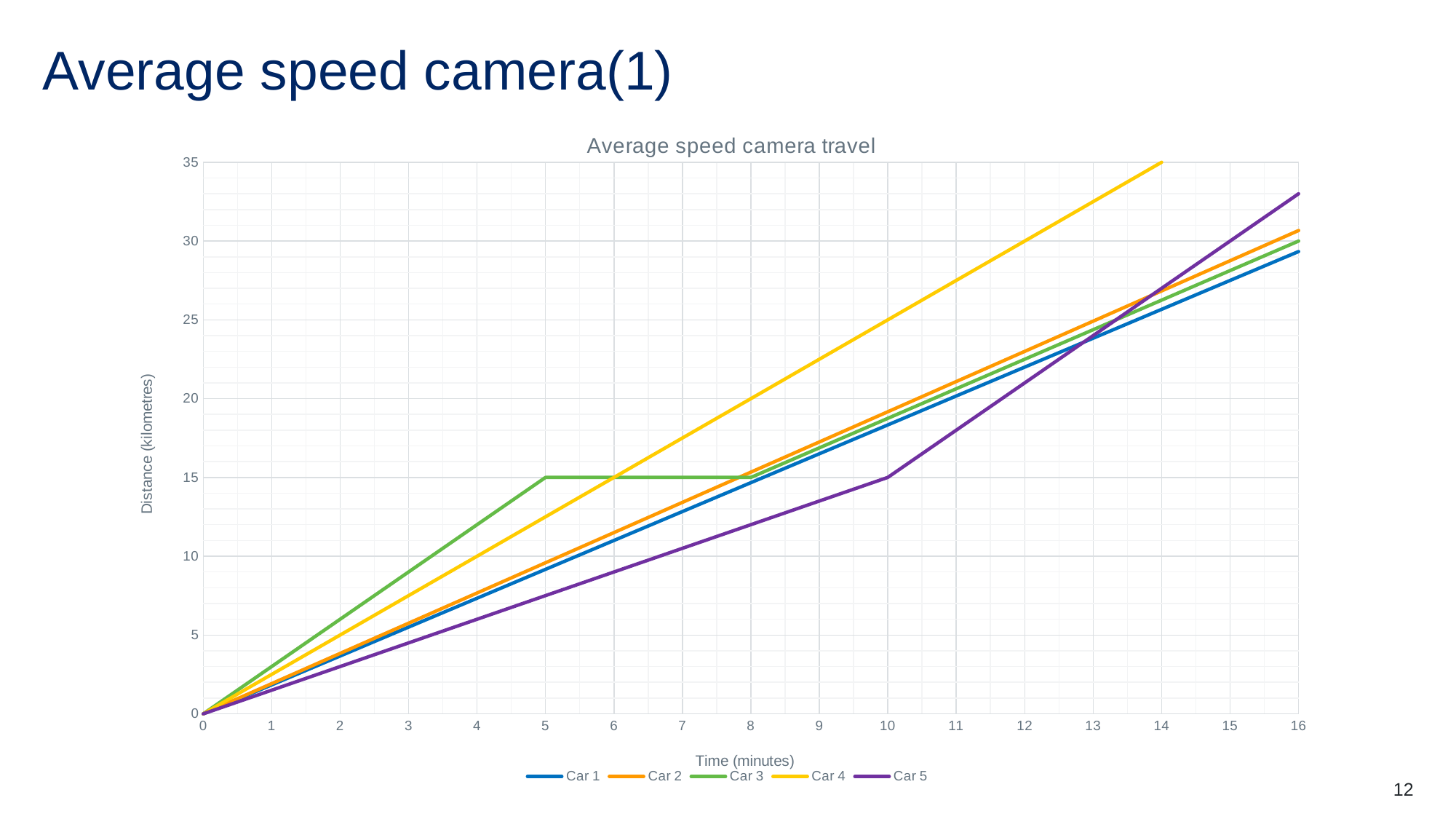
What distance has Car 4 travelled at 14 minutes? 35 Which car has travelled the greatest distance at 4 minutes? Car 3 What type of chart is shown on the slide? line chart What is the label of the vertical axis? Distance (kilometres) Which car has travelled the shortest distance at 8 minutes? Car 5 What is the title of the chart? Average speed camera travel Which car reaches 35 kilometres first? Car 4 What distance has Car 5 travelled at 10 minutes? 15 At 12 minutes, which has travelled further, Car 4 or Car 5? Car 4 Is the distance for Car 1 at 16 minutes greater or less than 30? less What distance has Car 3 travelled at 5 minutes? 15 How many series does the legend list? 5